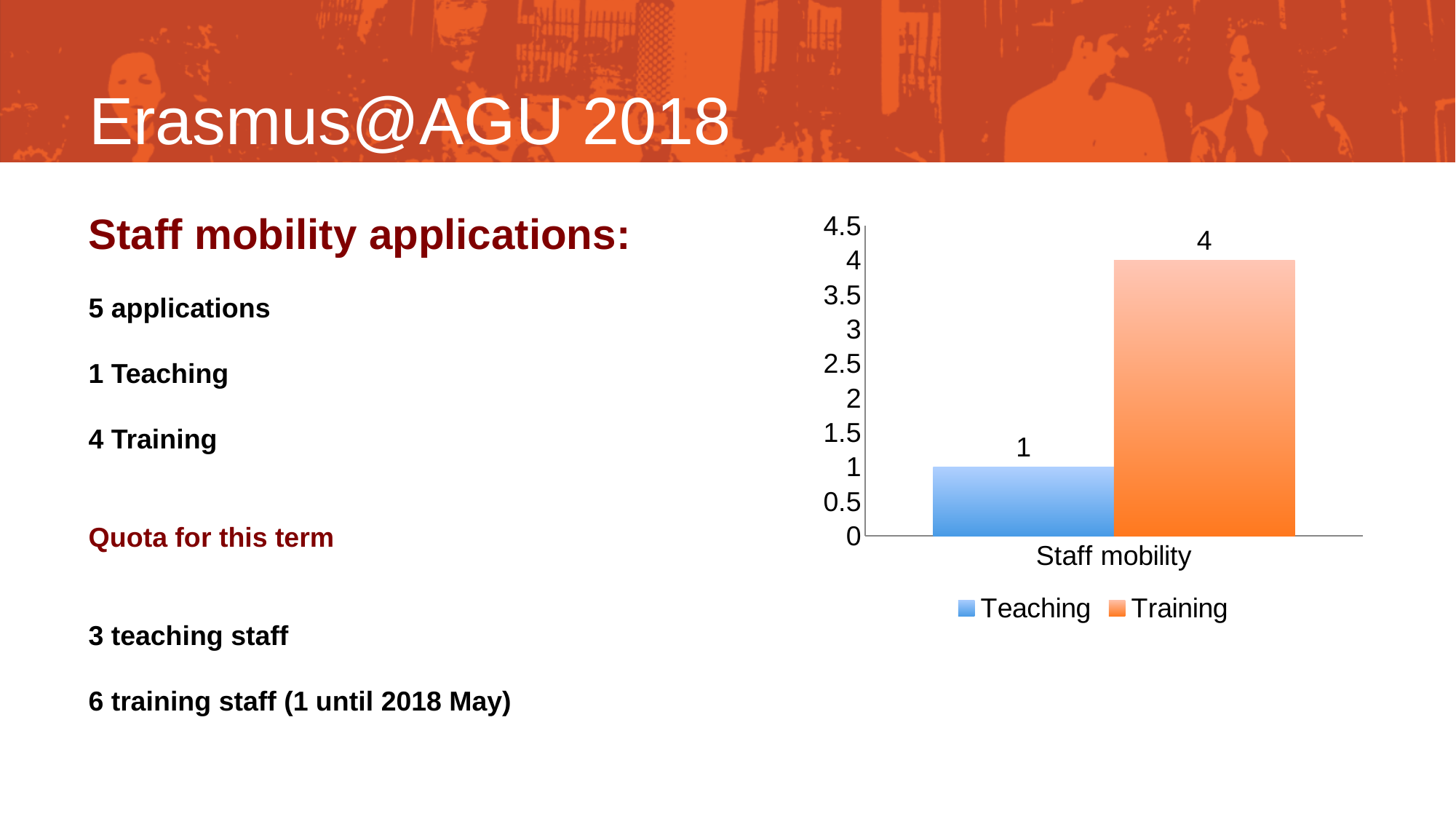
Is the value for Teaching greater or less than 2? less What is the value for Training in the Staff mobility chart? 4 Which series has the highest value in the chart? Training What is the value for Teaching in the Staff mobility chart? 1 What colour is the Training bar in the chart? orange What is the category label on the x axis of the chart? Staff mobility What kind of chart is shown on the slide? bar chart How many series does the legend list? 2 Which series has the lowest value in the chart? Teaching What is the difference between the Training and Teaching values? 3 Is the value for Training greater or less than 3? greater Which is larger, the value for Teaching or the value for Training? Training